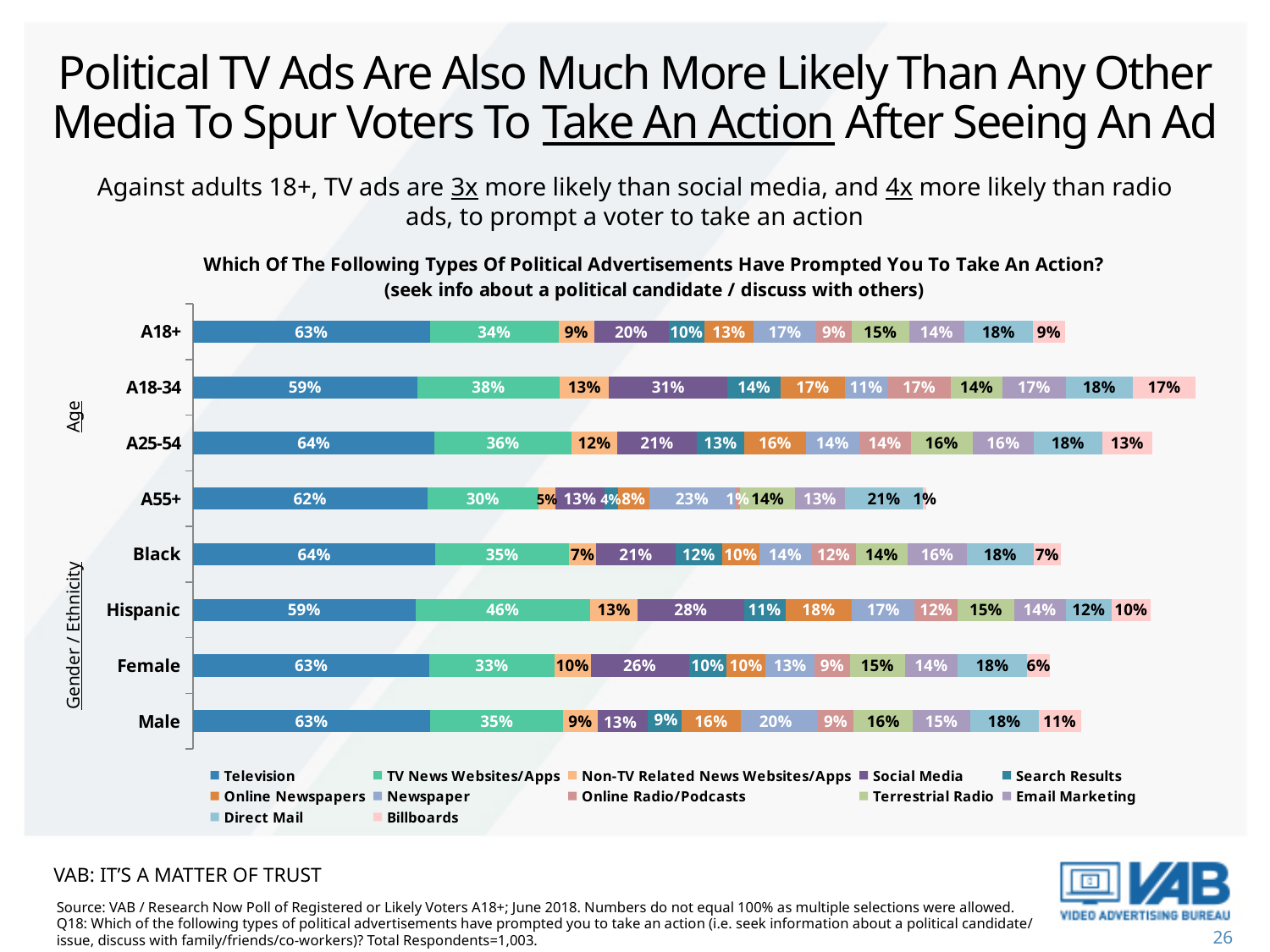
What is the Social Media value for the A18-34 group? 31% How many demographic groups are shown on the chart? 8 How many advertisement types does the legend list? 12 What is the Newspaper value for the A55+ group? 23% What percentage of A18+ adults said Television ads prompted them to take an action? 63% Which group has the lowest Social Media value? Male and A55+ (both 13%) What type of chart is shown on the slide? Stacked bar chart Which advertisement type is represented by the first (dark blue) segment of each bar? Television What is the TV News Websites/Apps value for Hispanic respondents? 46% Which group has the highest TV News Websites/Apps value? Hispanic For A18+, how many percentage points higher is Television than Social Media? 43 percentage points Which has the larger Social Media value, Female or Male? Female